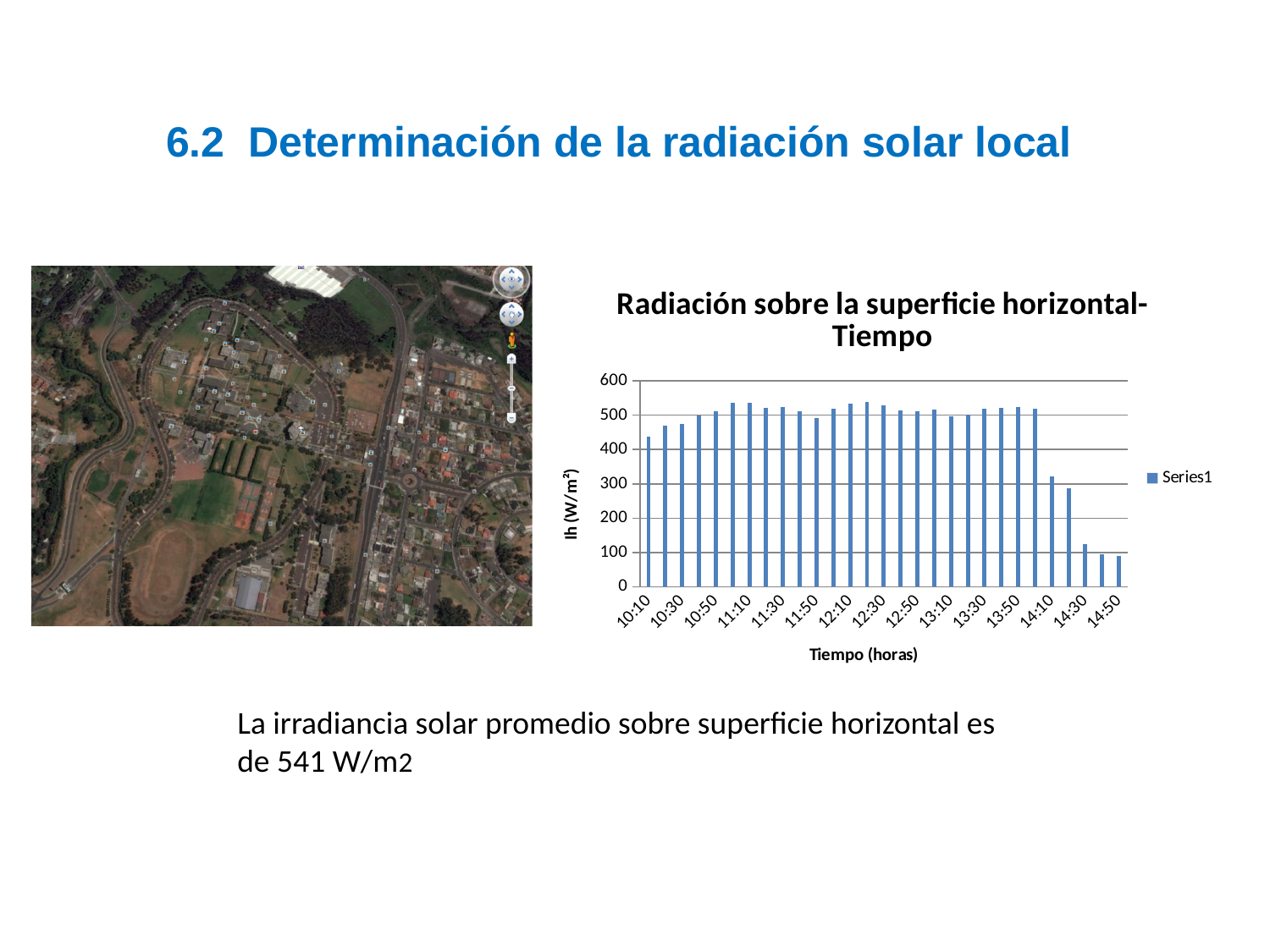
What is the title of the chart on the slide? Radiación sobre la superficie horizontal-Tiempo Is the value for 12:30 greater or less than 500? greater Is the value for 14:10 greater or less than 300? greater How many series does the chart legend list? 1 Is the value for 14:50 greater or less than 100? less How many time labels are shown along the x axis of the chart? 15 Which is larger, the value for 10:10 or the value for 14:50? 10:10 What is the label of the vertical axis of the chart? Ih (W/m²) What kind of chart is shown on the slide? Bar chart Do the values rise or fall from 14:10 to 14:50? fall